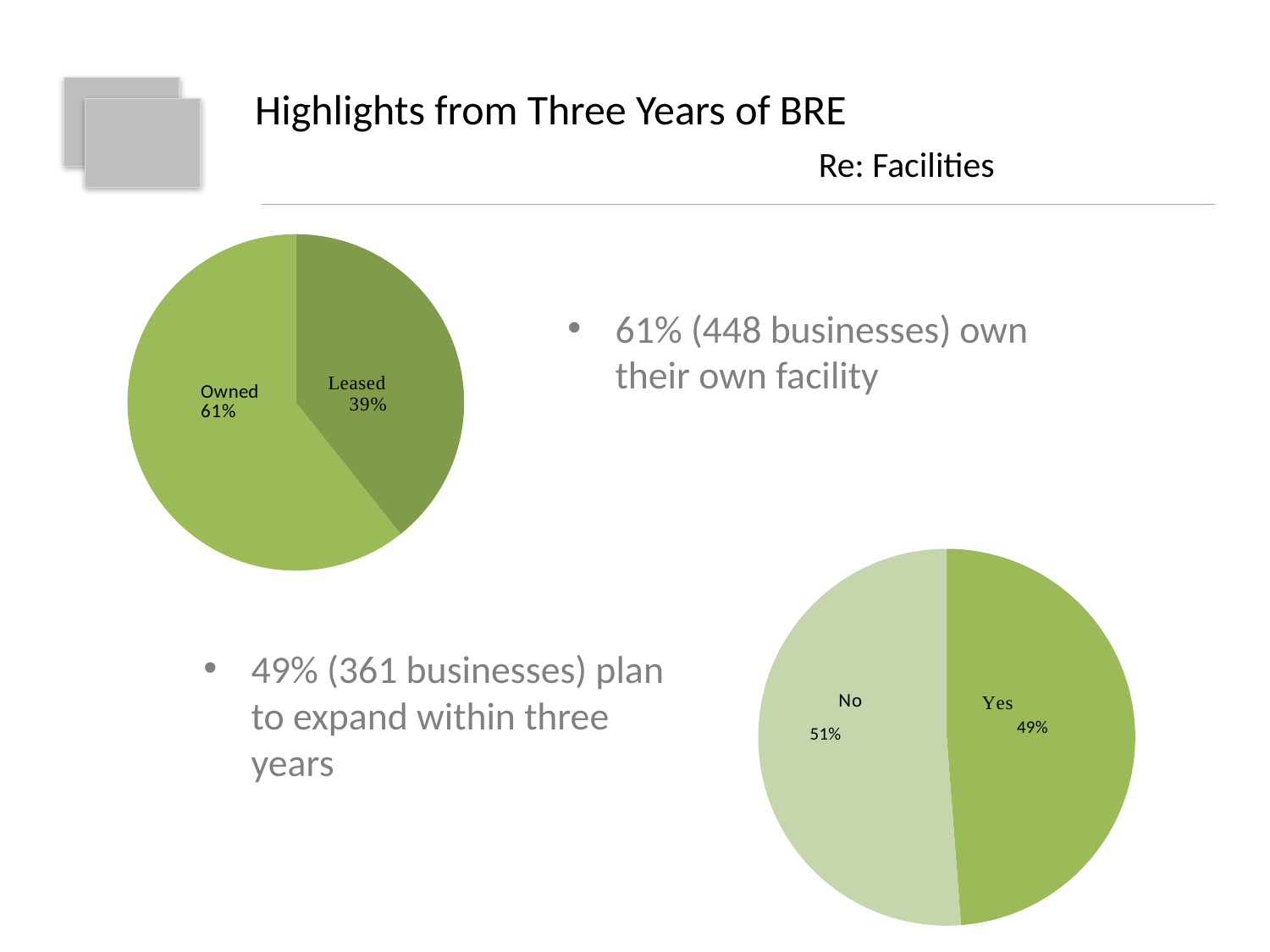
In the bottom-right pie chart, what share is labelled for No? 51% In the top-left pie chart, what share is labelled for Leased? 39% How many pie charts are shown on the slide? 2 How many slices does the bottom-right pie chart have? 2 In the bottom-right pie chart, which slice is larger, Yes or No? No In the top-left pie chart, which slice is the smallest? Leased In the bottom-right pie chart, what share is labelled for Yes? 49% In the top-left pie chart, what is the difference in percentage points between Owned and Leased? 22 In the top-left pie chart, which slice is the largest? Owned How many slices does the top-left pie chart have? 2 In the top-left pie chart, what share is labelled for Owned? 61% What kind of chart is the top-left chart? Pie chart